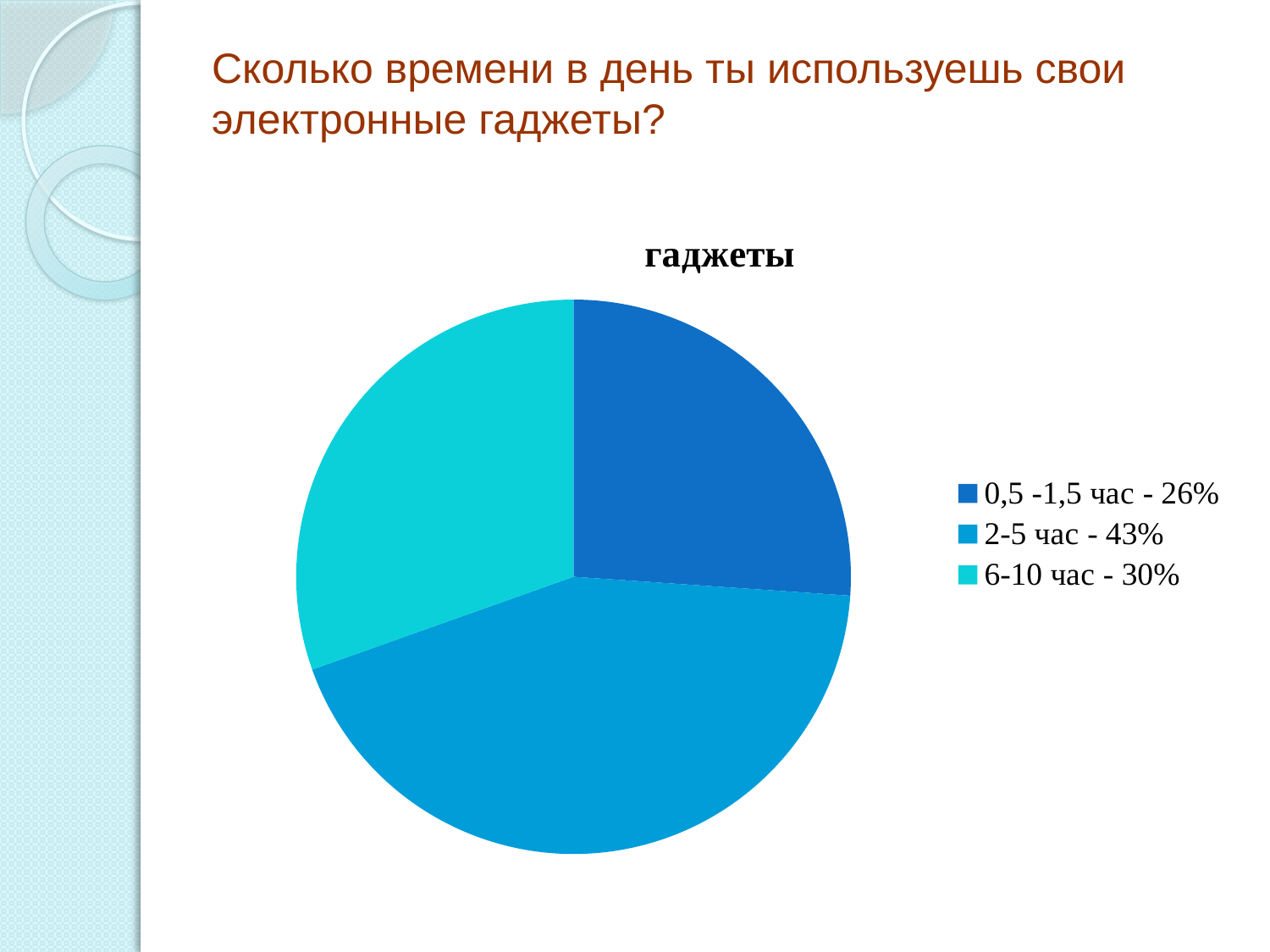
How many entries does the legend list? 3 What share of the pie is the "2-5 час" slice? 43% What kind of chart is shown on the slide? pie chart What colour is the "6-10 час" slice in the legend? light turquoise What is the difference in percentage points between the "2-5 час" slice and the "6-10 час" slice? 13% What share of the pie is the "6-10 час" slice? 30% Which is larger: the "6-10 час" slice or the "0,5 -1,5 час" slice? 6-10 час What share of the pie is the "0,5 -1,5 час" slice? 26% How many slices does the pie chart have? 3 What is the title of the chart? гаджеты Which category has the smallest slice of the pie? 0,5 -1,5 час Which category has the largest slice of the pie? 2-5 час